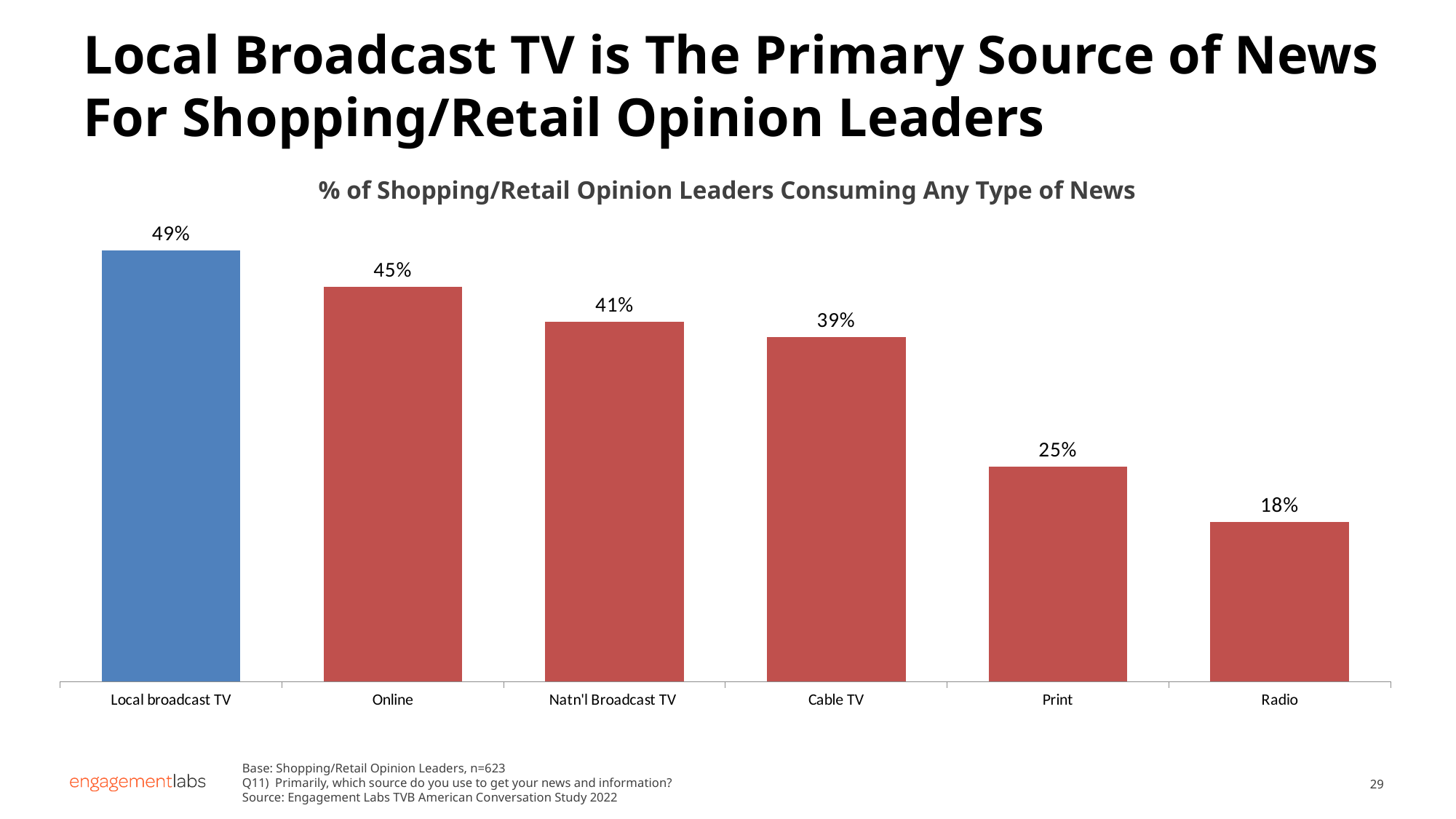
What percentage of Shopping/Retail Opinion Leaders consume news via Local broadcast TV? 49% What is the difference between the values for Print and Radio? 7% Which bar is coloured blue rather than red? Local broadcast TV Which news source has the lowest percentage? Radio What is the difference between the values for Local broadcast TV and Online? 4% Which is larger, the value for Natn'l Broadcast TV or the value for Cable TV? Natn'l Broadcast TV How many news sources are shown in the chart? 6 Which news source has the highest percentage? Local broadcast TV What is the value shown for Radio? 18% What is the value shown for Cable TV? 39% What is the value shown for Online? 45% What kind of chart is shown on the slide? Bar chart